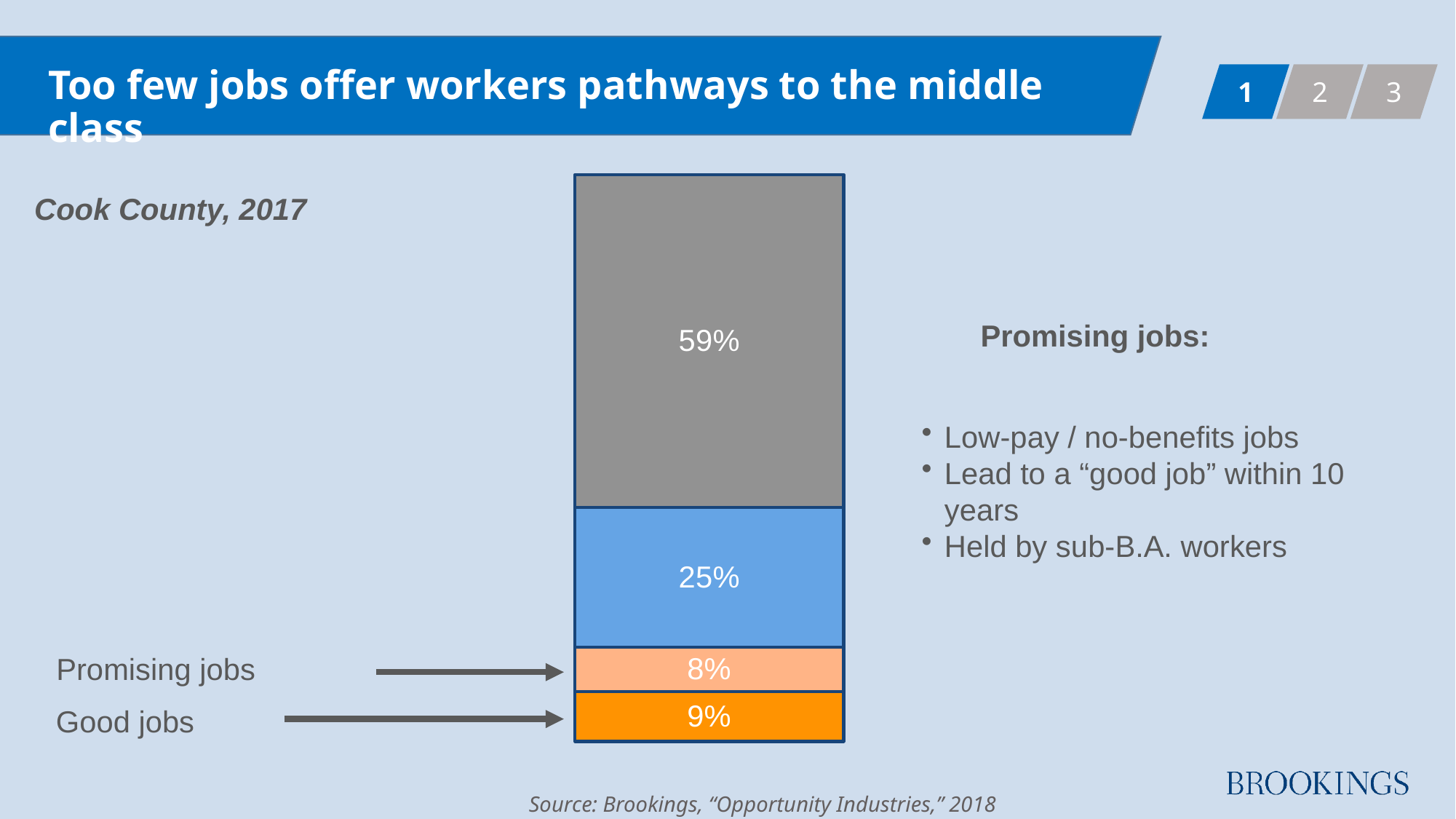
Which is larger, the share for Good jobs or the share for Promising jobs? Good jobs What kind of chart is shown on the slide? Stacked bar chart What share of jobs in Cook County, 2017 are labeled as Promising jobs? 8% What is the value printed on the largest segment of the stacked bar? 59% What colour is the segment labeled Good jobs? Orange What is the value printed on the smallest segment of the stacked bar? 8% What is the value printed on the blue segment of the bar? 25% What is the difference between the Good jobs share and the Promising jobs share? 1 percentage point How many segments make up the stacked bar? 4 What share of jobs in Cook County, 2017 are labeled as Good jobs? 9% What county and year does the chart describe? Cook County, 2017